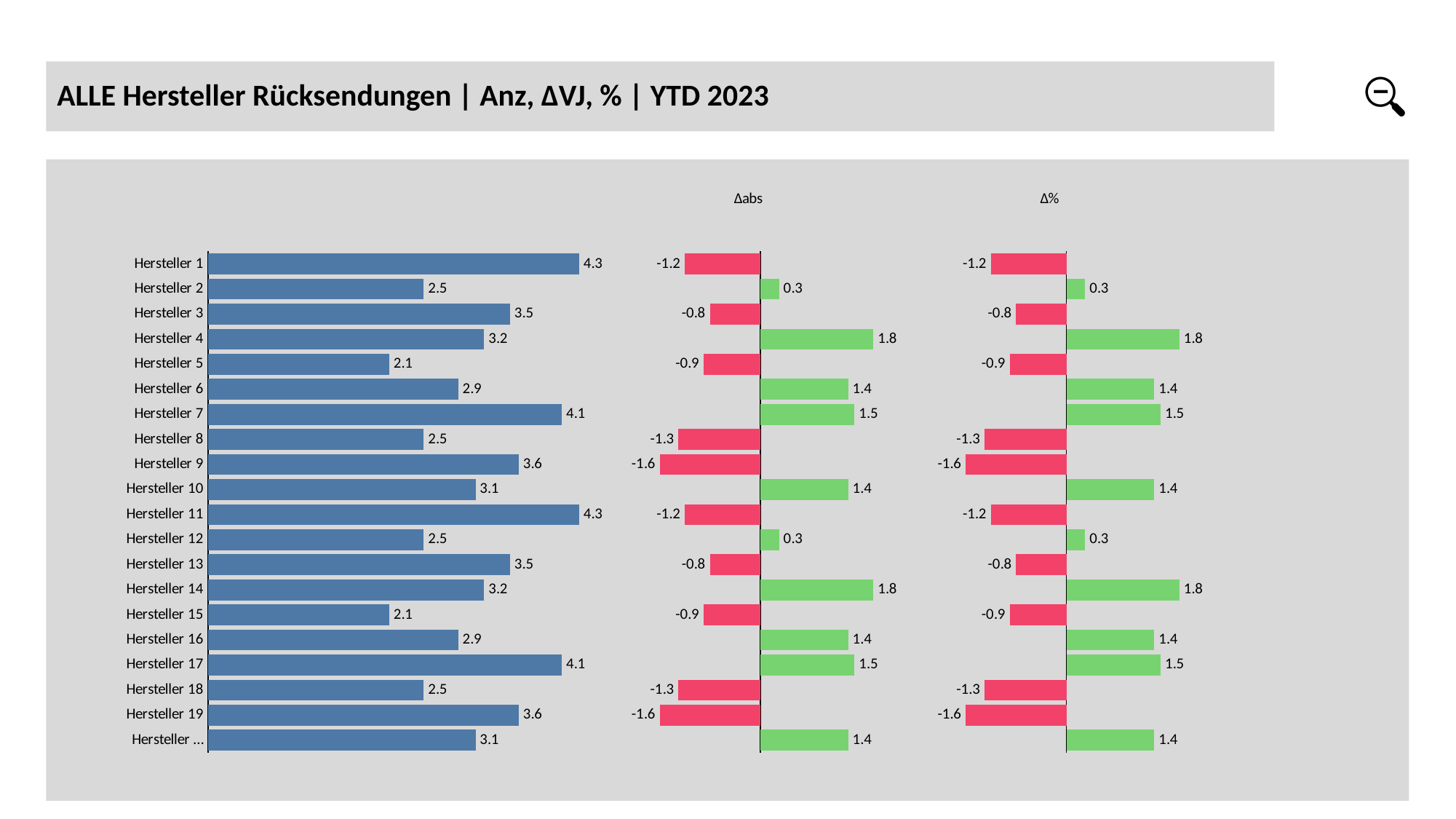
How many categories (Hersteller) are listed in the left blue bar chart? 20 What kind of chart is the left chart on the slide? Bar chart In the Δ% chart, what is the value for Hersteller 4? 1.8 In the left blue bar chart, what is the difference between the values for Hersteller 1 and Hersteller 2? 1.8 In the Δabs chart, what is the value for Hersteller 9? -1.6 In the left blue bar chart, what is the value for Hersteller 15? 2.1 In the left blue bar chart, what is the largest value shown? 4.3 In the left blue bar chart, what is the value for Hersteller 7? 4.1 What is the title of the slide? ALLE Hersteller Rücksendungen | Anz, ΔVJ, % | YTD 2023 In the Δabs chart, which is larger, the value for Hersteller 2 or Hersteller 10? Hersteller 10 In the Δabs chart, what is the lowest value shown? -1.6 In the left blue bar chart, which is larger, the value for Hersteller 3 or Hersteller 6? Hersteller 3